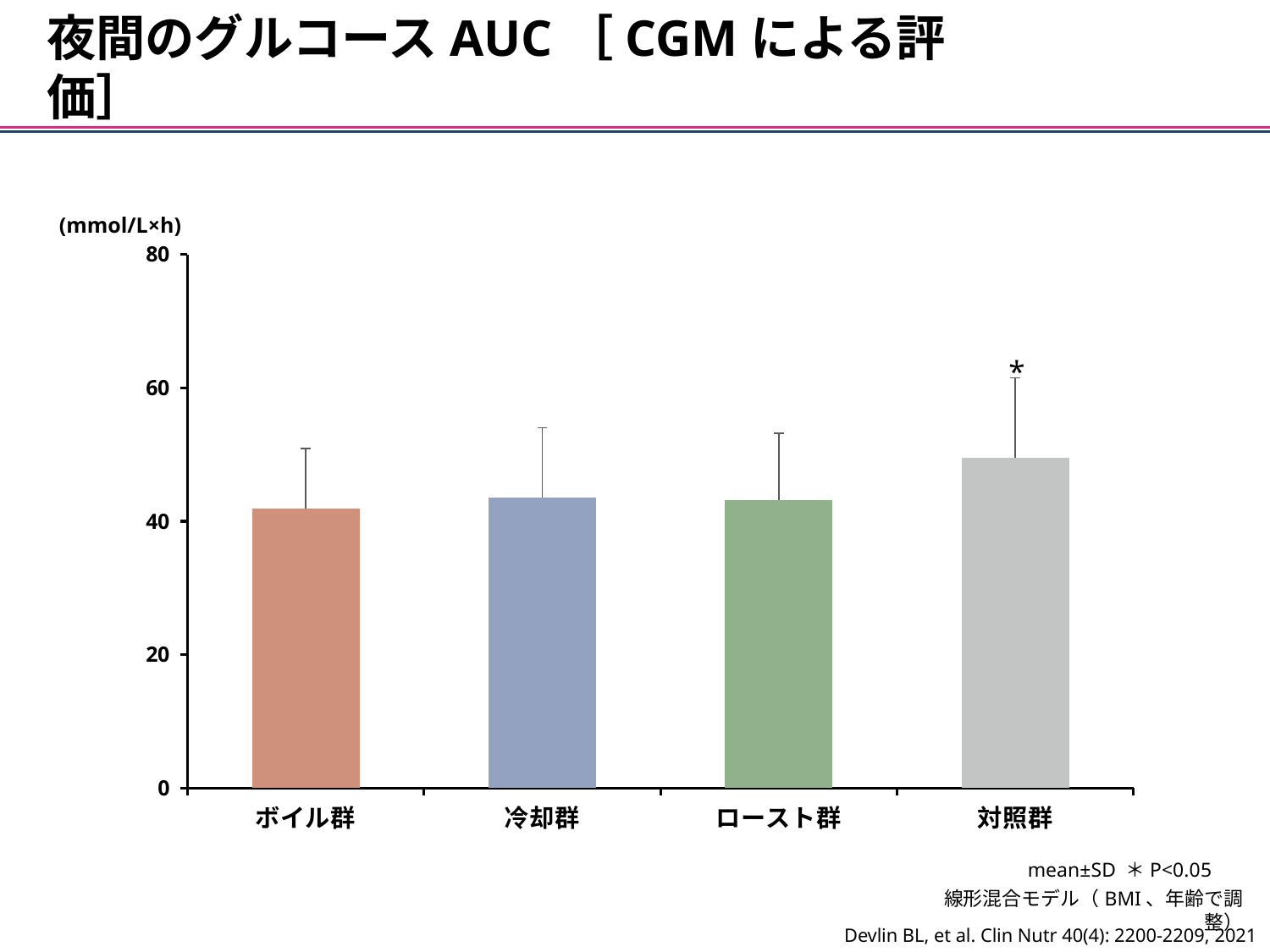
What unit is shown for the y axis? mmol/L×h Is the value for 冷却群 greater or less than 60? less How many groups (categories) are plotted on the x axis? 4 Which group's bar is marked with an asterisk (*)? 対照群 Is the value for 対照群 greater or less than 40? greater Is the value for ロースト群 greater or less than 20? greater What kind of chart is shown on the slide? bar chart Which group has the highest nocturnal glucose AUC? 対照群 Which is larger, the value for 対照群 or the value for ボイル群? 対照群